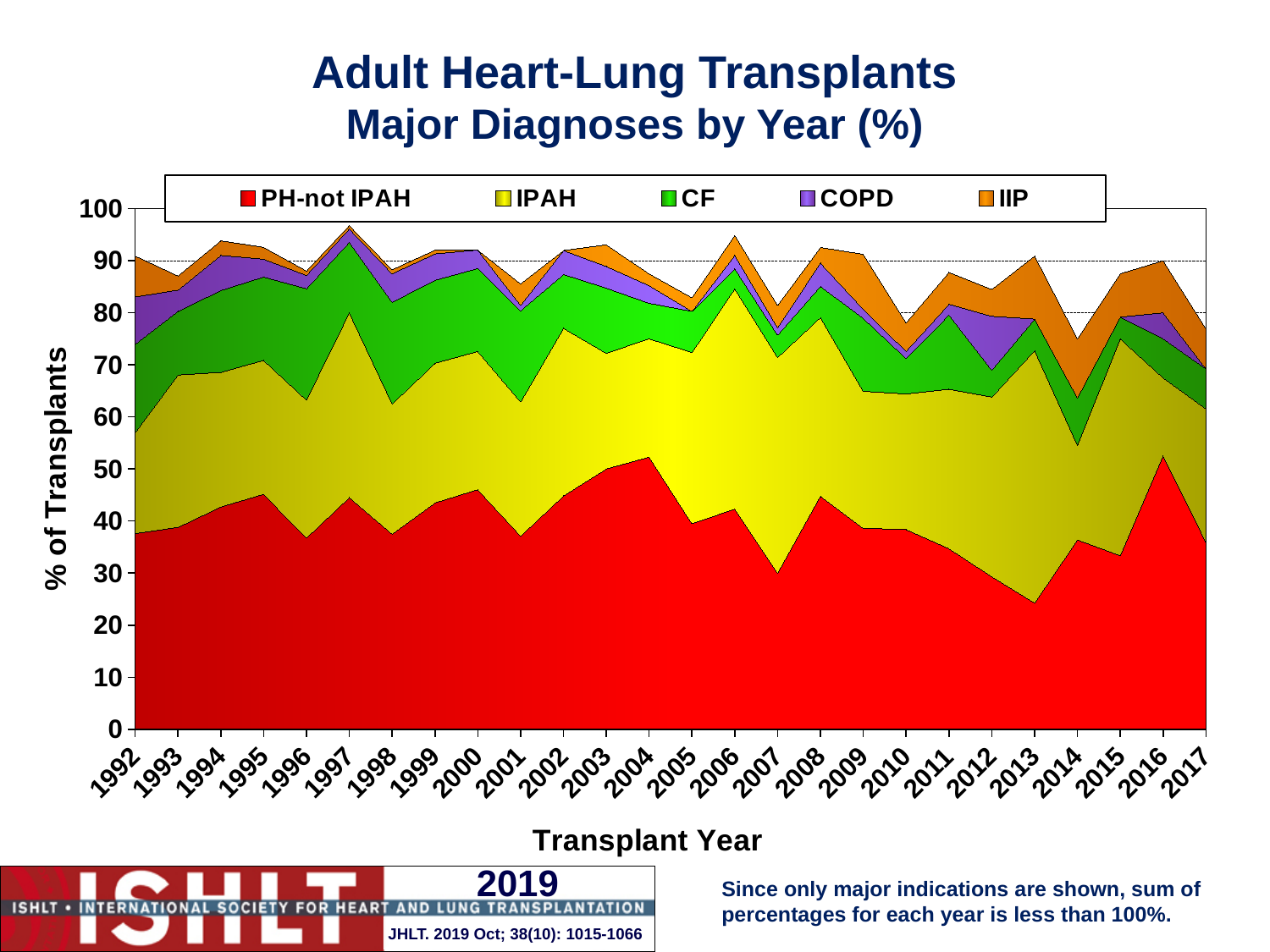
What is the label of the y axis? % of Transplants Is the value for PH-not IPAH in 2004 greater or less than 50? greater Is the total of the stacked areas in 1997 greater or less than 90? greater Is the value for PH-not IPAH in 2013 greater or less than 30? less What kind of chart is shown on the slide? Stacked area chart In which year is the PH-not IPAH share lowest? 2013 Does the PH-not IPAH share rise or fall from 2008 to 2013? Fall Which series is shown in red? PH-not IPAH How many transplant years are shown on the x axis? 26 Which is larger, the PH-not IPAH value in 2004 or in 2013? 2004 How many series does the legend list? 5